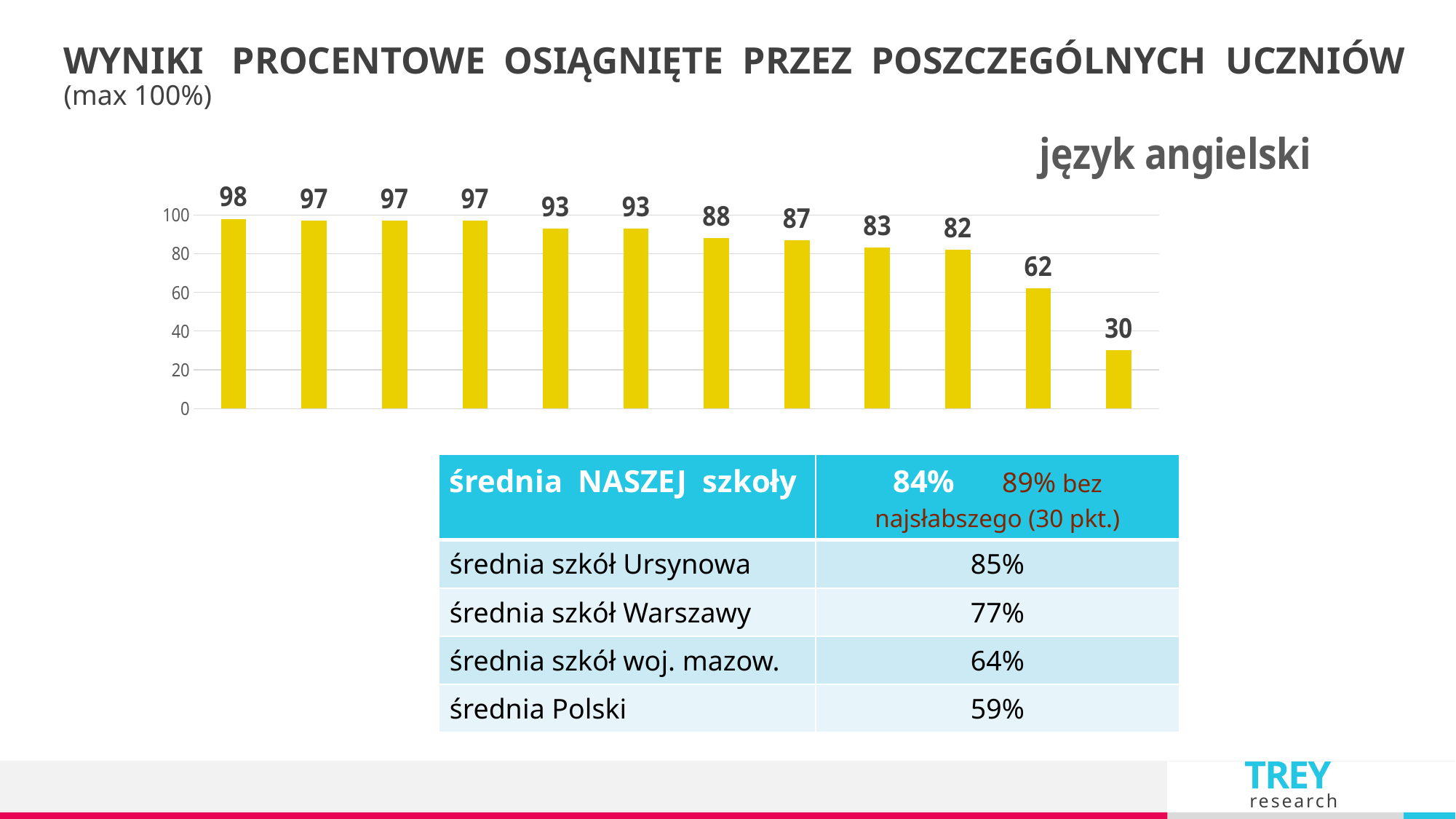
Which is larger: the value of the seventh bar from the left or the eighth bar from the left? the seventh bar (88) What is the value of the first (leftmost) bar in the chart? 98 What is the difference between the highest and the lowest bar values in the chart? 68 Do the bar values rise or fall from left to right across the chart? fall What is the highest value shown in the chart? 98 How many bars does the chart contain? 12 What is the value of the second-to-last bar in the chart? 62 Which subject is named in the label above the chart? język angielski How many bars in the chart have a value of 97? 3 What is the lowest value shown in the chart? 30 What kind of chart is shown on the slide? bar chart What is the value of the last (rightmost) bar in the chart? 30